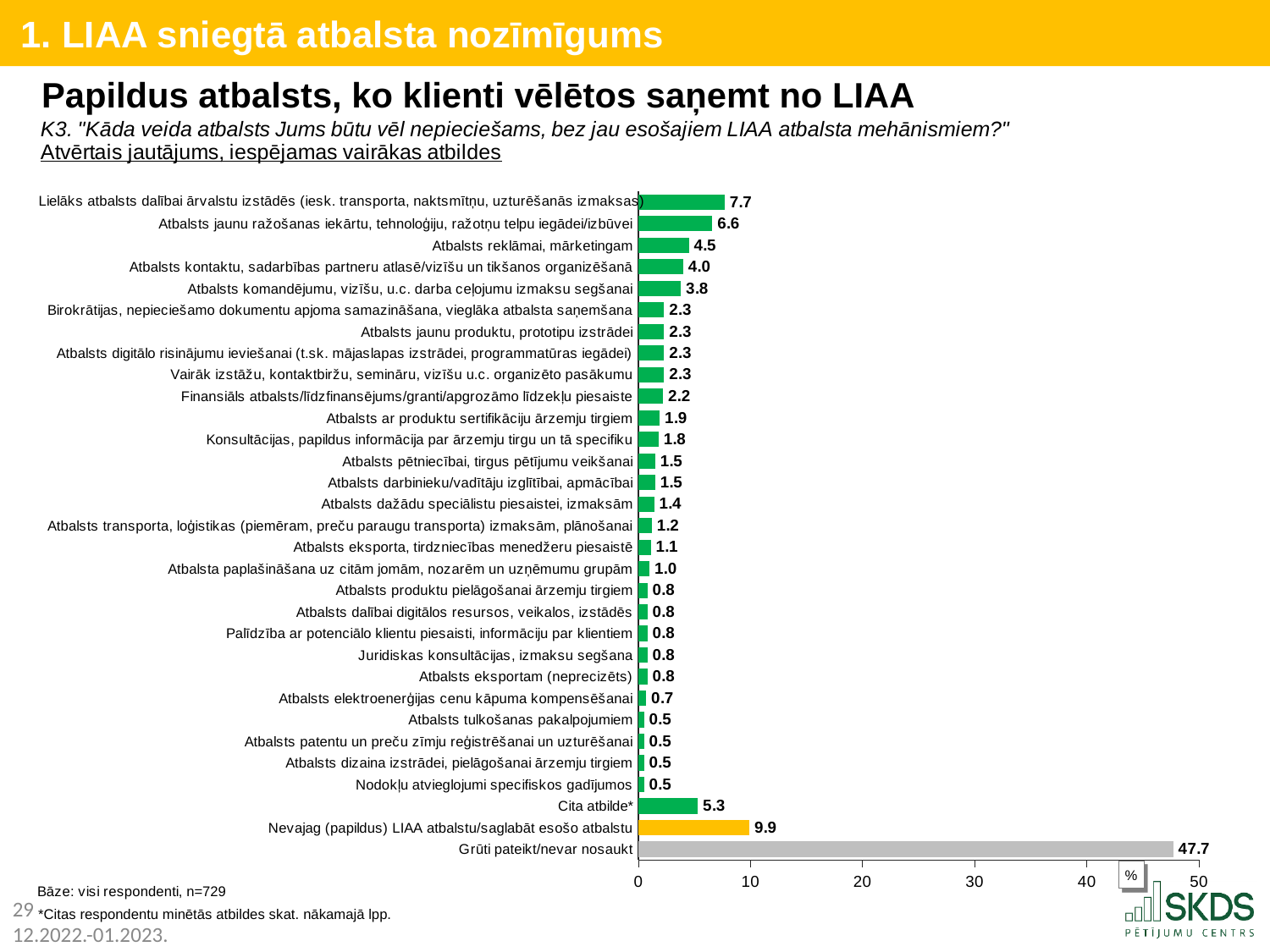
What is the value for "Atbalsts reklāmai, mārketingam"? 4.5 Which category has the highest value? Grūti pateikt/nevar nosaukt What is the value for "Cita atbilde*"? 5.3 What colour is the bar for "Grūti pateikt/nevar noteikt"? grey What is the value for "Nevajag (papildus) LIAA atbalstu/saglabāt esošo atbalstu"? 9.9 What is the difference between the values for "Lielāks atbalsts dalībai ārvalstu izstādēs" and "Atbalsts jaunu ražošanas iekārtu, tehnoloģiju, ražotņu telpu iegādei/izbūvei"? 1.1 Which is larger: the value for "Atbalsts kontaktu, sadarbības partneru atlasē/vizīšu un tikšanos organizēšanā" or for "Atbalsts komandējumu, vizīšu, u.c. darba ceļojumu izmaksu segšanai"? Atbalsts kontaktu, sadarbības partneru atlasē/vizīšu un tikšanos organizēšanā What is the value for "Atbalsts jaunu ražošanas iekārtu, tehnoloģiju, ražotņu telpu iegādei/izbūvei"? 6.6 Is the value for "Grūti pateikt/nevar noteikt" greater or less than 40? greater What kind of chart is shown on the slide? bar chart How many categories are shown in the chart? 31 Which category has the highest value among the green bars? Lielāks atbalsts dalībai ārvalstu izstādēs (iesk. transporta, naktsmītņu, uzturēšanās izmaksas)